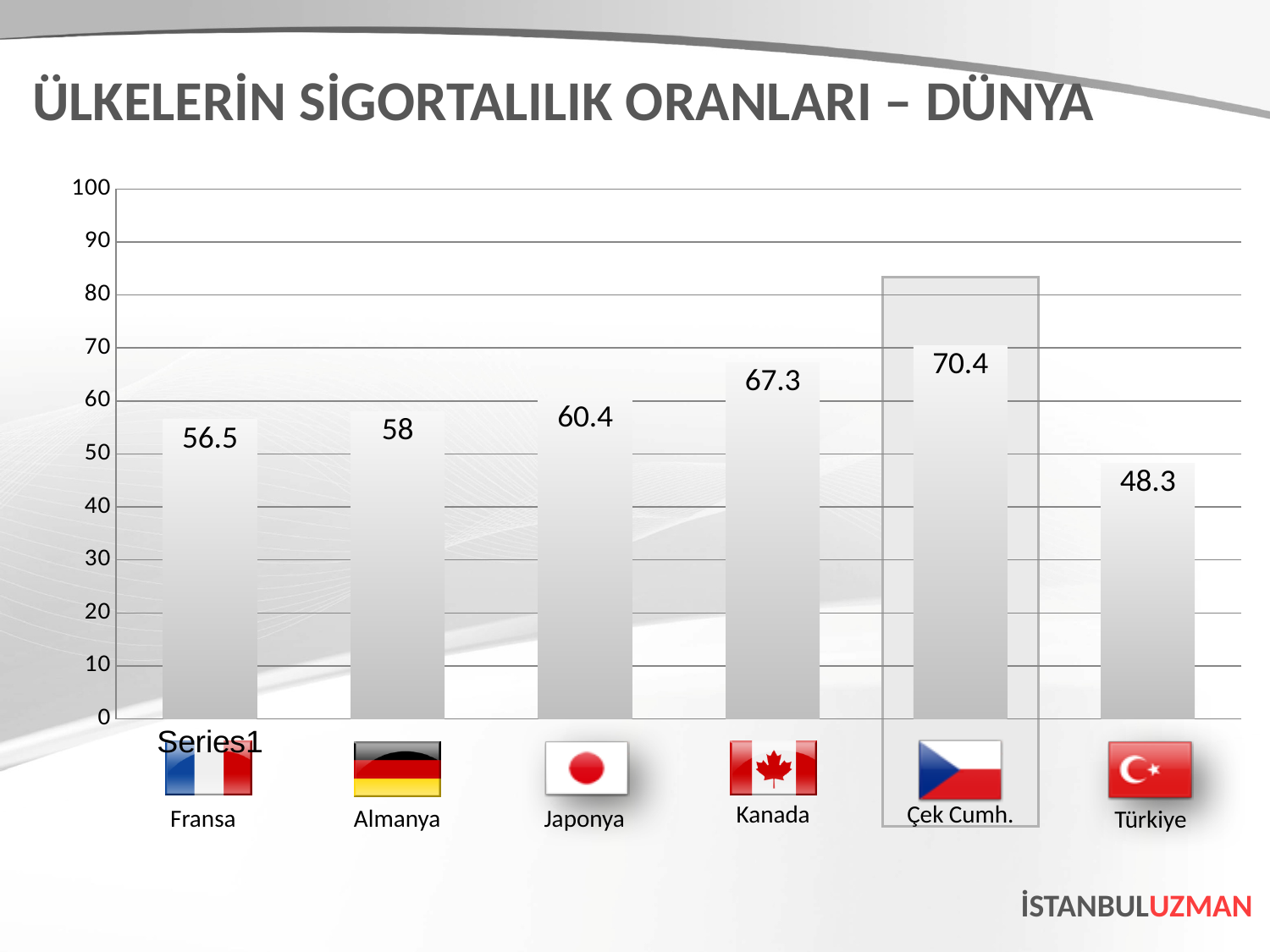
How many countries are shown in the chart? 6 Is the value for Almanya greater or less than 50? greater What is the difference between the values for Japonya and Almanya? 2.4 Which country has the lowest value? Türkiye What is the title of the slide? ÜLKELERİN SİGORTALILIK ORANLARI – DÜNYA Which country has the highest value? Çek Cumh. What kind of chart is shown on the slide? bar chart Which is larger, the value for Kanada or the value for Japonya? Kanada What is the difference between the values for Çek Cumh. and Türkiye? 22.1 What is the value for Fransa? 56.5 What is the value for Kanada? 67.3 What is the value for Türkiye? 48.3